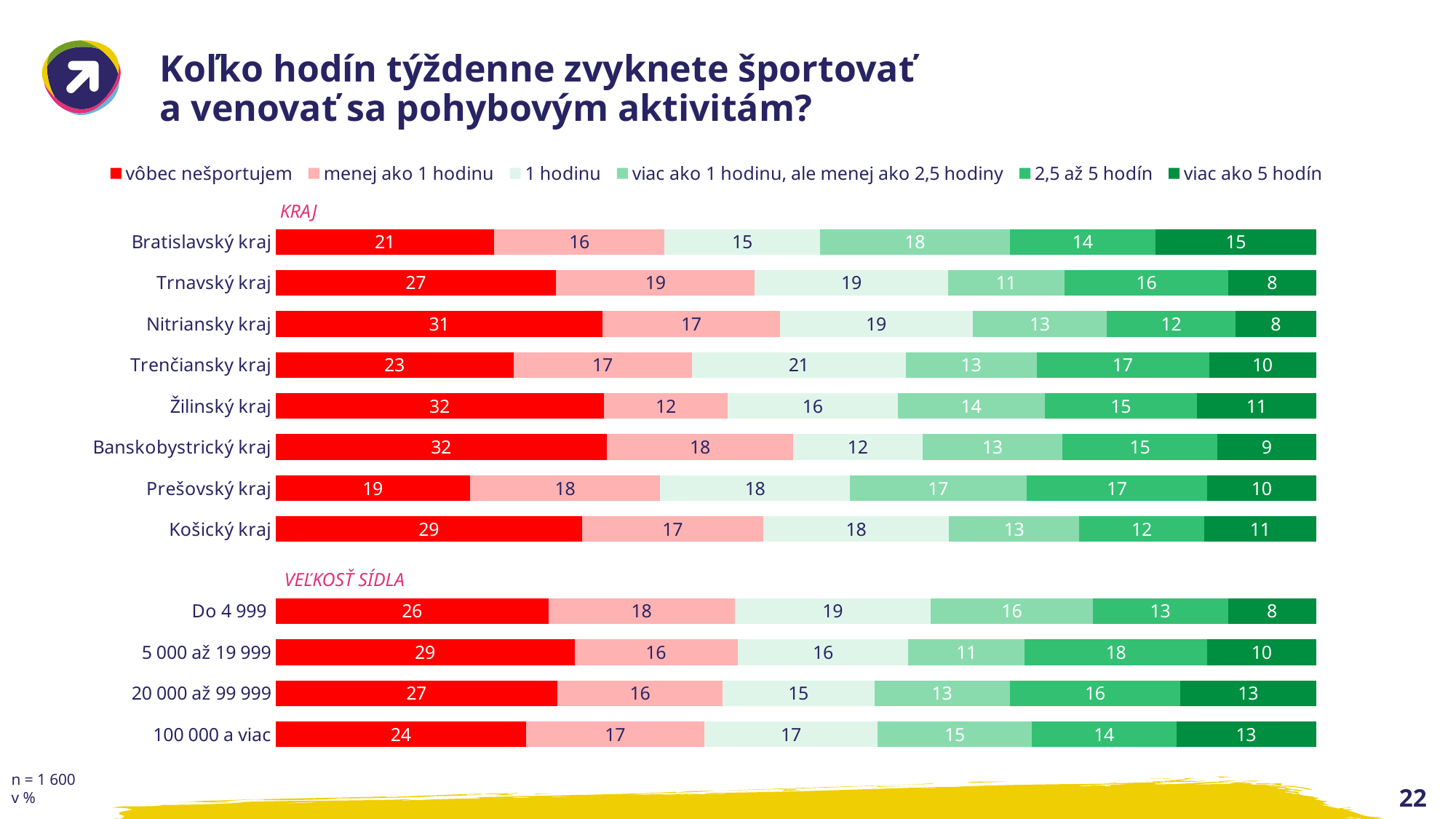
Which has a larger "vôbec nešportujem" value: "Do 4 999" or "5 000 až 19 999"? 5 000 až 19 999 What is the difference between the "vôbec nešportujem" values for Nitriansky kraj and Bratislavský kraj? 10 What is the value for "viac ako 5 hodín" in Trenčiansky kraj? 10 Which region (kraj) has the lowest value for "vôbec nešportujem"? Prešovský kraj How many categories (bars) are plotted in total on the chart? 12 What is the value for "1 hodinu" in the "100 000 a viac" settlement size category? 17 What is the sample size (n) stated on the slide? n = 1 600 Which region (kraj) has the highest value for "viac ako 5 hodín"? Bratislavský kraj What kind of chart is shown on the slide? Stacked bar chart Which has a larger "2,5 až 5 hodín" value: Trnavský kraj or Košický kraj? Trnavský kraj How many series does the legend list? 6 What percentage of respondents in Bratislavský kraj answered "vôbec nešportujem"? 21